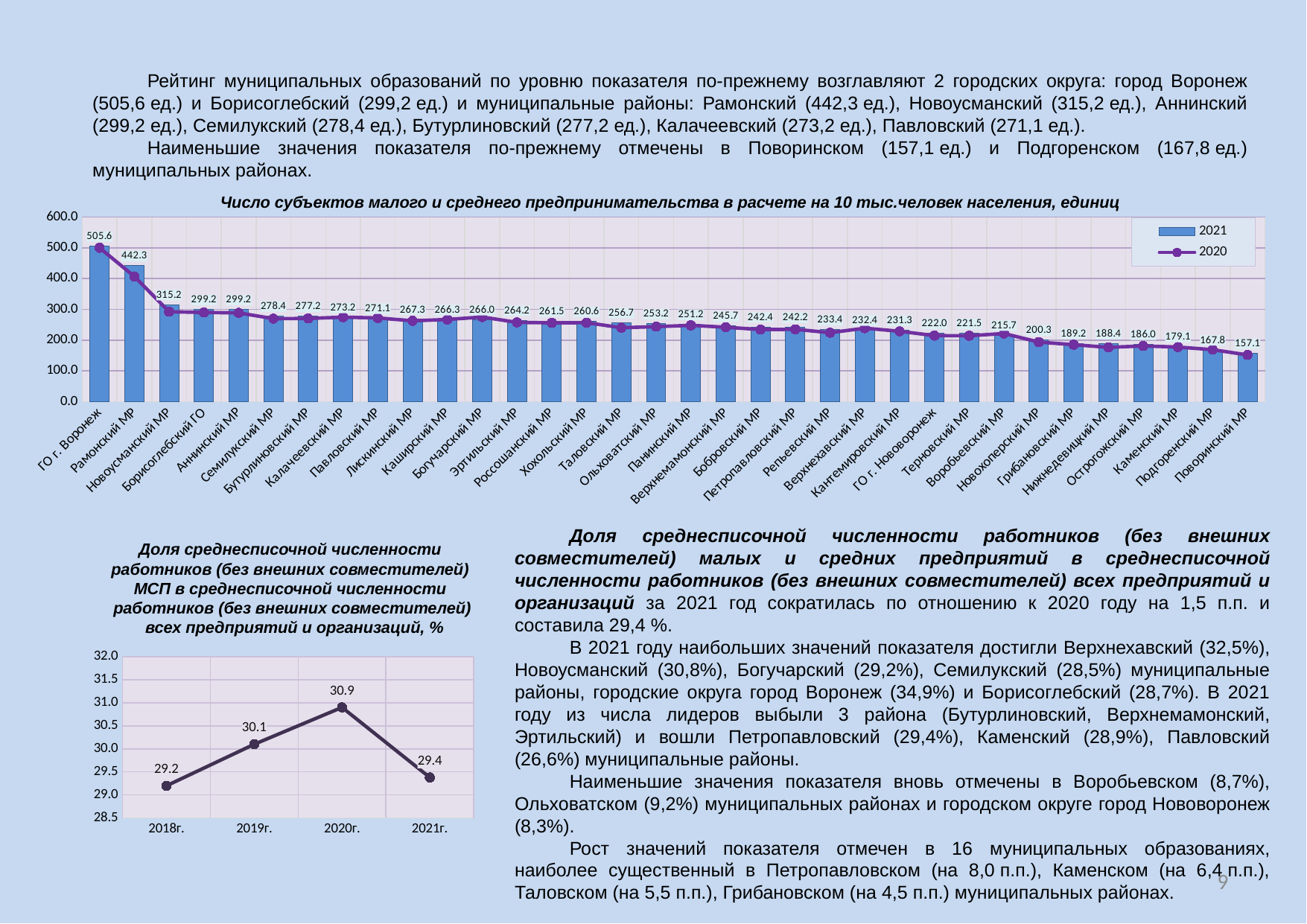
In the top chart, how many municipalities are shown on the x axis? 34 In the bottom-left chart 'Доля среднесписочной численности работников ... МСП ...', what is the value for 2020г.? 30.9 What type of chart is the bottom-left chart? Line chart In the top chart, which category has the highest 2021 value? ГО г. Воронеж In the top chart 'Число субъектов малого и среднего предпринимательства в расчете на 10 тыс.человек населения, единиц', what is the 2021 value for Рамонский МР? 442.3 In the top chart, how many series does the legend list? 2 In the top chart, which category has the lowest 2021 value? Поворинский МР In the top chart, is the 2020 value for ГО г. Воронеж greater or less than 400.0? greater In the bottom-left chart, what is the difference between the values for 2020г. and 2021г.? 1.5 In the top chart, which has a larger 2021 value: Новоусманский МР or Семилукский МР? Новоусманский МР In the top chart, what is the difference between the 2021 values for ГО г. Воронеж and Рамонский МР? 63.3 In the top chart, what is the 2021 value for Поворинский МР? 157.1